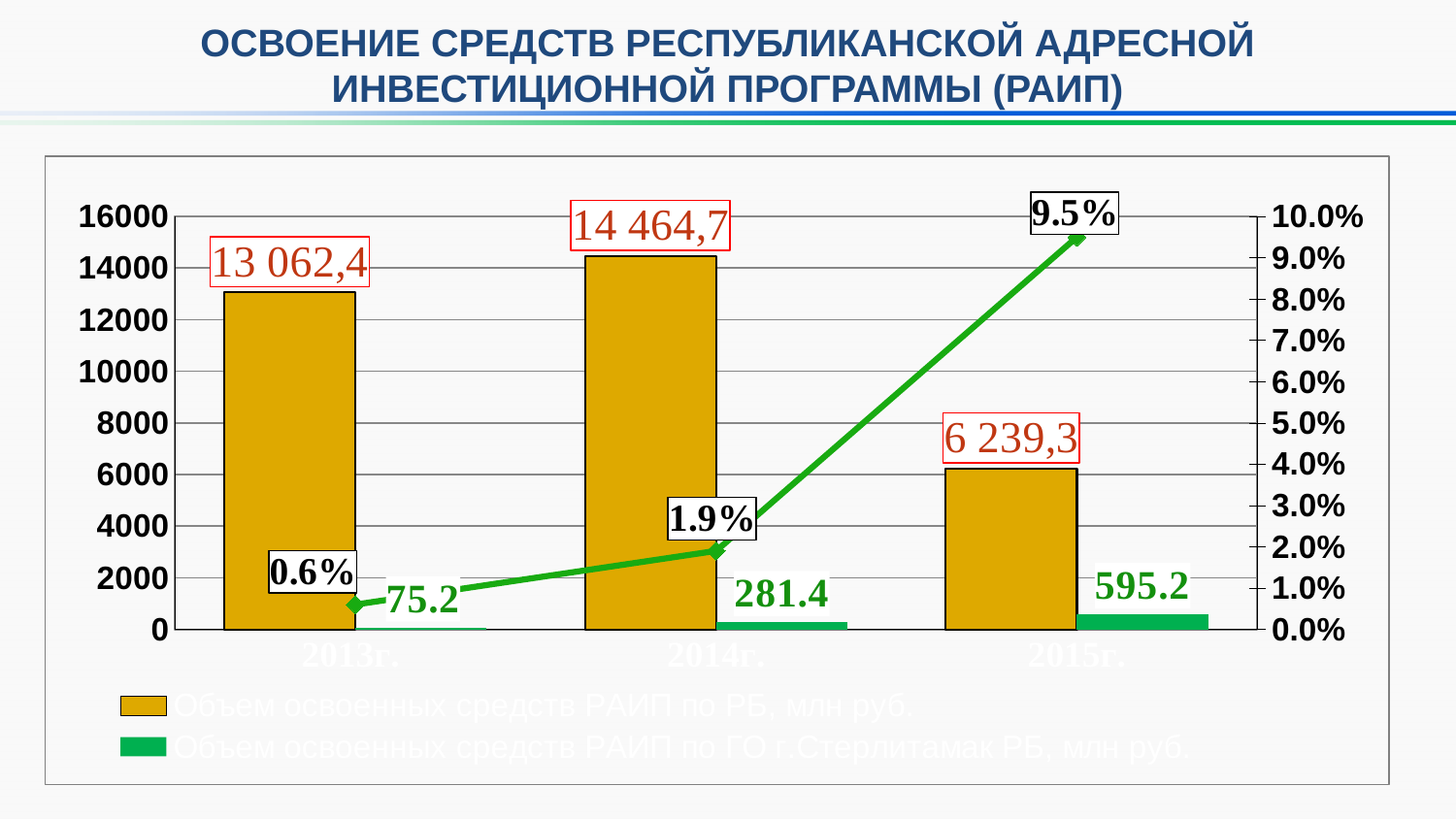
Which year has the larger gold bar, 2013г. or 2015г.? 2013г. In which year is the gold bar the highest? 2014г. What is the difference between the green bar values for 2015г. and 2013г.? 520.0 Is the gold bar value for 2015г. greater or less than 8000? less In which year is the gold bar the lowest? 2015г. What is the value of the green bar for 2015г.? 595.2 What is the difference between the gold bar values for 2014г. and 2013г.? 1 402,3 How many years are shown on the x axis? 3 What is the highest value shown on the right-hand percentage axis? 10.0% What percentage does the green line show for 2013г.? 0.6% What is the value of the gold bar for 2014г.? 14 464,7 Does the green line rise or fall from 2013г. to 2015г.? rises